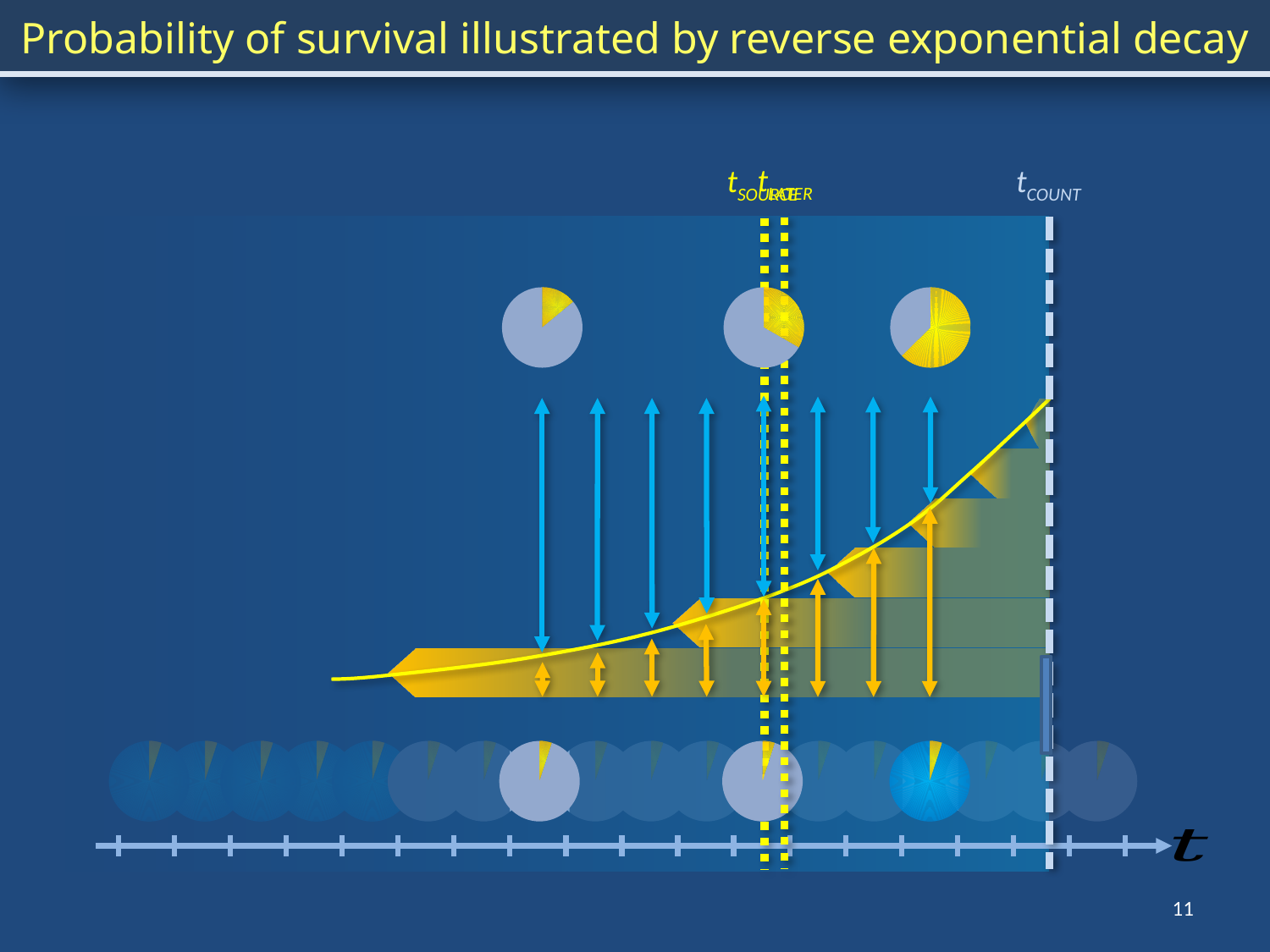
Does the yellow curve rise or fall as it moves from left to right along the t axis? rise How many pie-style circles are shown in the upper row above the curve? 3 What label is shown at the right end of the horizontal axis? t What is the title of the chart on the slide? Probability of survival illustrated by reverse exponential decay How many orange double-headed vertical arrows are drawn below the curve? 8 How many blue double-headed vertical arrows are drawn above the curve? 8